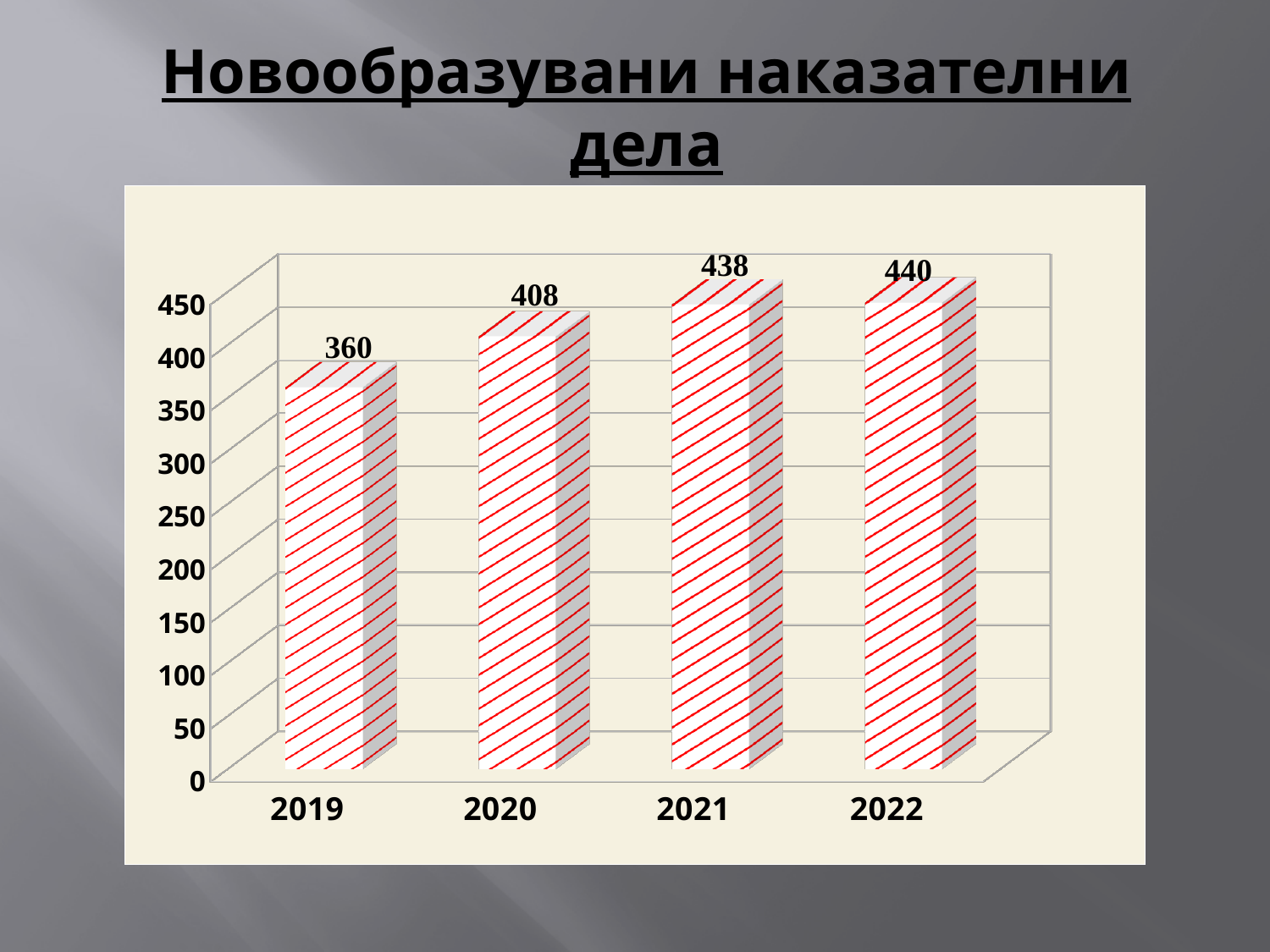
Which year has the lowest value? 2019 What kind of chart is shown on the slide? bar chart What is the value for 2021? 438 Do the values rise or fall from 2019 to 2022? rise What is the value for 2019? 360 What is the value for 2022? 440 What is the difference between the values for 2022 and 2021? 2 Which is larger, the value for 2020 or the value for 2021? 2021 How many years are shown on the x axis? 4 What is the difference between the values for 2020 and 2019? 48 What is the value for 2020? 408 Is the value for 2019 greater or less than 400? less